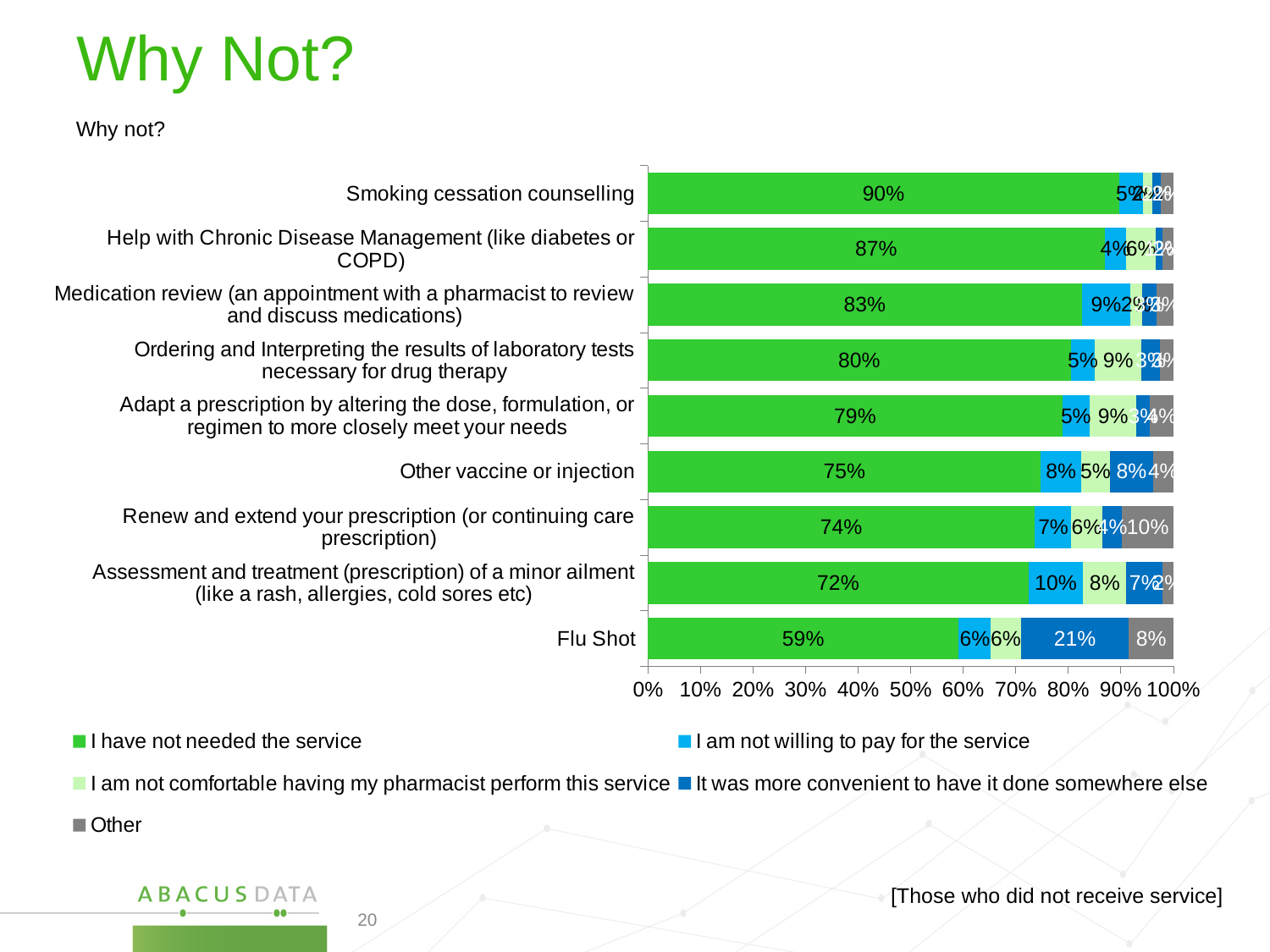
How many categories (services) are shown in the chart? 9 What percentage of respondents said 'I am not willing to pay for the service' for Assessment and treatment (prescription) of a minor ailment? 10% What percentage of respondents said 'I have not needed the service' for Smoking cessation counselling? 90% Which service has the lowest share of 'I have not needed the service' responses? Flu Shot Which service has the highest share of 'I have not needed the service' responses? Smoking cessation counselling How many series does the legend list? 5 What percentage of respondents said 'It was more convenient to have it done somewhere else' for Flu Shot? 21% Which has a larger 'I have not needed the service' share: Other vaccine or injection, or Flu Shot? Other vaccine or injection What is the difference in 'I have not needed the service' between Smoking cessation counselling and Flu Shot? 31 percentage points What type of chart is shown on the slide? Stacked bar chart What percentage of respondents said 'I have not needed the service' for Flu Shot? 59% What percentage of respondents chose 'Other' for Renew and extend your prescription? 10%